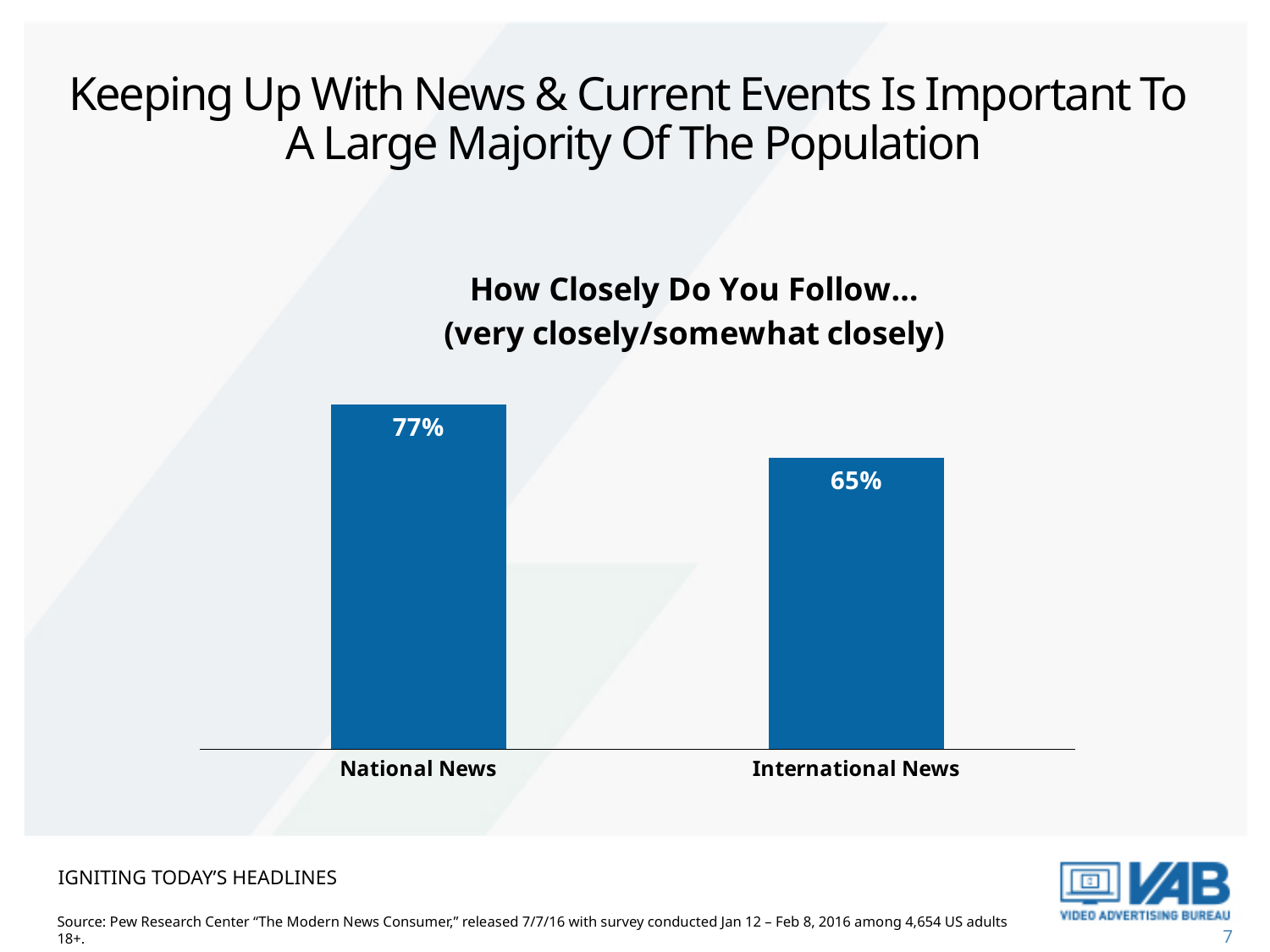
What is the title of the chart? How Closely Do You Follow… (very closely/somewhat closely) What percentage of respondents follow International News very closely or somewhat closely? 65% Which category has the lowest value in the chart? International News What colour are the bars in the chart? Blue What is the difference in percentage points between National News and International News? 12 percentage points How many categories are shown in the chart? 2 Which category has the highest value in the chart? National News What kind of chart is shown on the slide? Bar chart What percentage of respondents follow National News very closely or somewhat closely? 77% Which is larger, the value for National News or the value for International News? National News